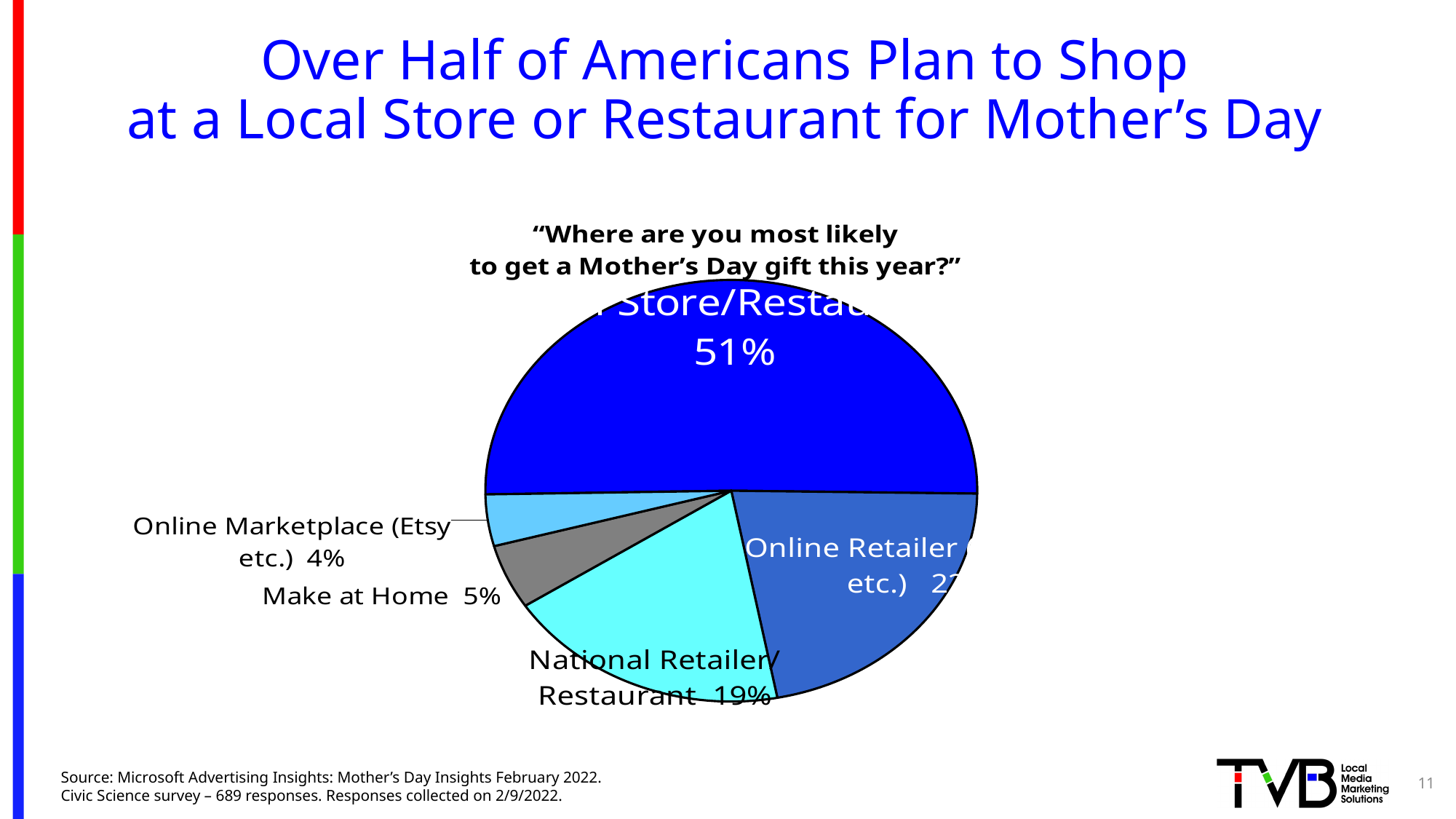
What is the combined share of Make at Home and Online Marketplace (Etsy etc.)? 9% What kind of chart is shown on the slide? pie chart What percentage of respondents chose National Retailer/Restaurant? 19% What survey question is shown as the chart's title? "Where are you most likely to get a Mother's Day gift this year?" What percentage of respondents chose Make at Home? 5% Which is larger: the share for Make at Home or the share for Online Marketplace (Etsy etc.)? Make at Home How many slices does the pie chart have? 5 What share of respondents said they are most likely to get a Mother's Day gift at a local store/restaurant? 51% Which response has the largest share of the pie? Local Store/Restaurant Which response has the smallest share of the pie? Online Marketplace (Etsy etc.) What is the difference in percentage points between National Retailer/Restaurant and Make at Home? 14 What percentage of respondents chose Online Marketplace (Etsy etc.)? 4%